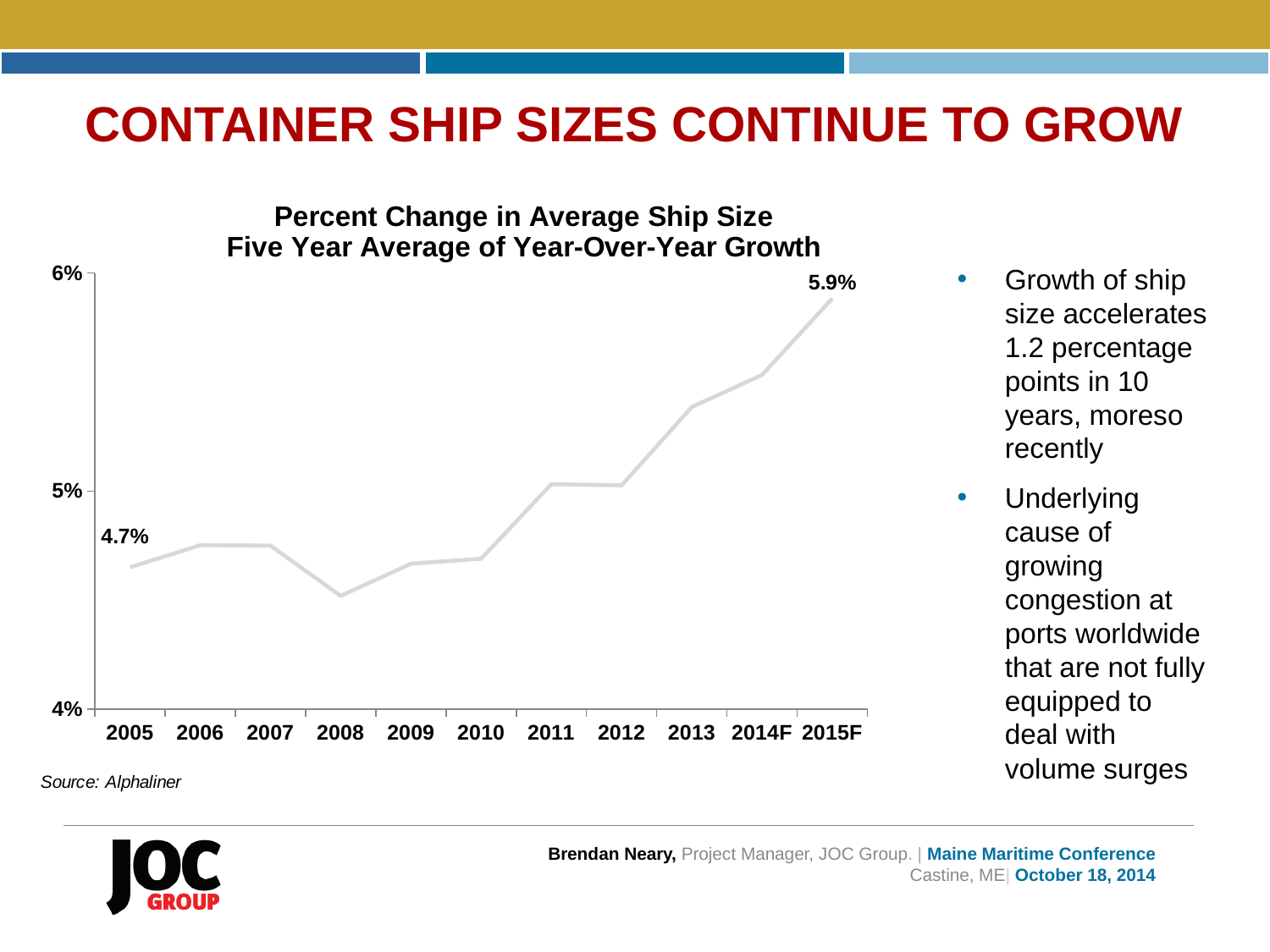
Which year has the lowest value in the chart? 2008 What kind of chart is shown on the slide? Line chart Is the value for 2013 greater or less than 5%? greater How many years are plotted on the x axis of the chart? 11 Is the value for 2008 greater or less than 5%? less What is the value for 2005 in the chart? 4.7% What is the title of the chart? Percent Change in Average Ship Size Five Year Average of Year-Over-Year Growth Which year has the highest value in the chart? 2015F Do the values generally rise or fall from 2005 to 2015F? Rise What is the difference between the 2015F value and the 2005 value? 1.2 percentage points What is the value for 2015F in the chart? 5.9% Which is larger, the value for 2013 or the value for 2009? 2013